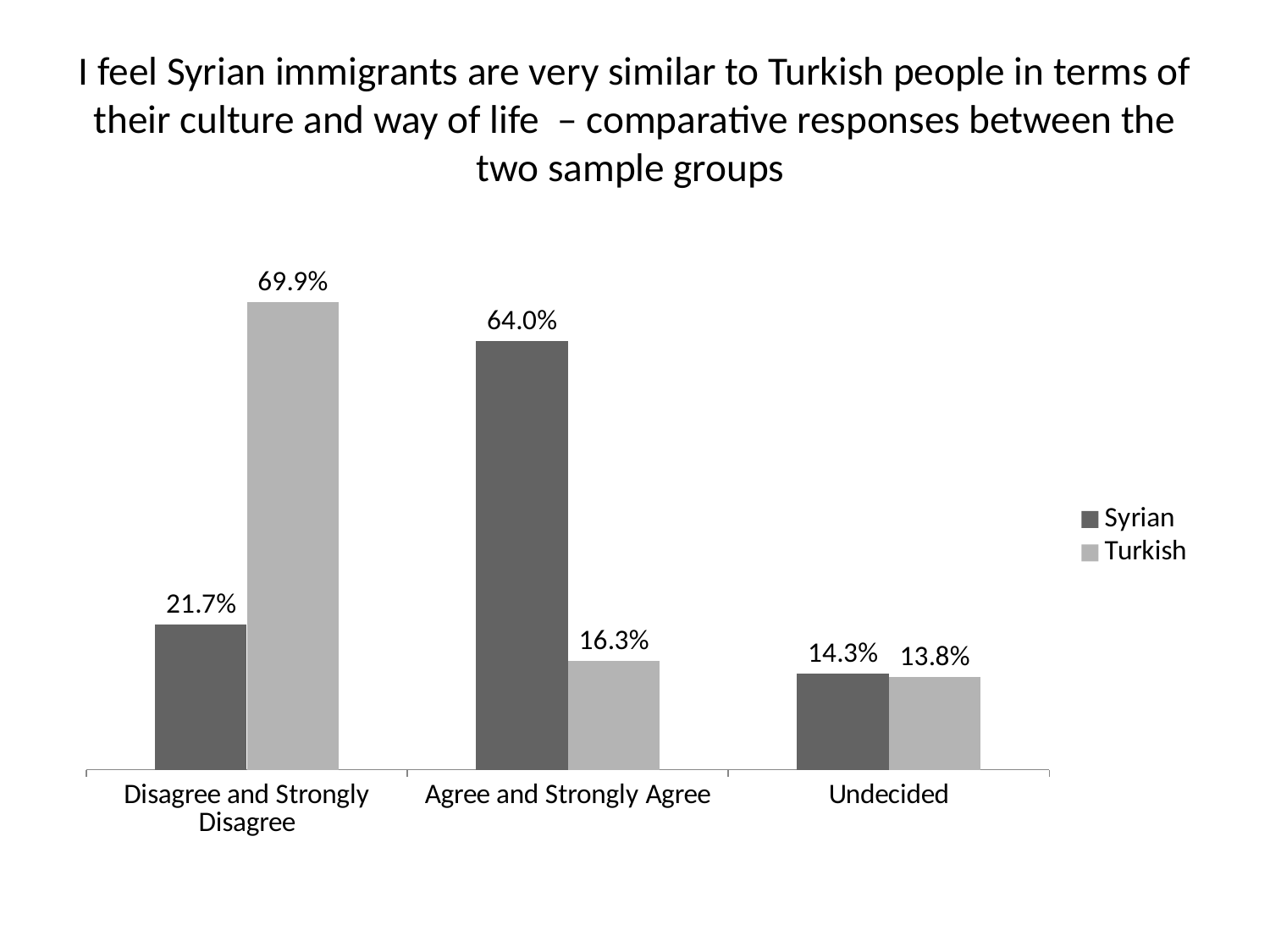
What kind of chart is shown on the slide? Bar chart What percentage of the Syrian sample responded 'Agree and Strongly Agree'? 64.0% What is the difference between the Turkish and Syrian values for 'Disagree and Strongly Disagree'? 48.2% How many response categories are shown on the x axis? 3 What percentage of the Turkish sample responded 'Disagree and Strongly Disagree'? 69.9% Which response category has the lowest value for the Syrian sample? Undecided What percentage of the Turkish sample responded 'Undecided'? 13.8% How many series does the legend list? 2 For 'Agree and Strongly Agree', which sample group has the larger value, Syrian or Turkish? Syrian Which response category has the highest value for the Turkish sample? Disagree and Strongly Disagree What percentage of the Syrian sample responded 'Disagree and Strongly Disagree'? 21.7% What is the difference between the Syrian and Turkish values for 'Agree and Strongly Agree'? 47.7%